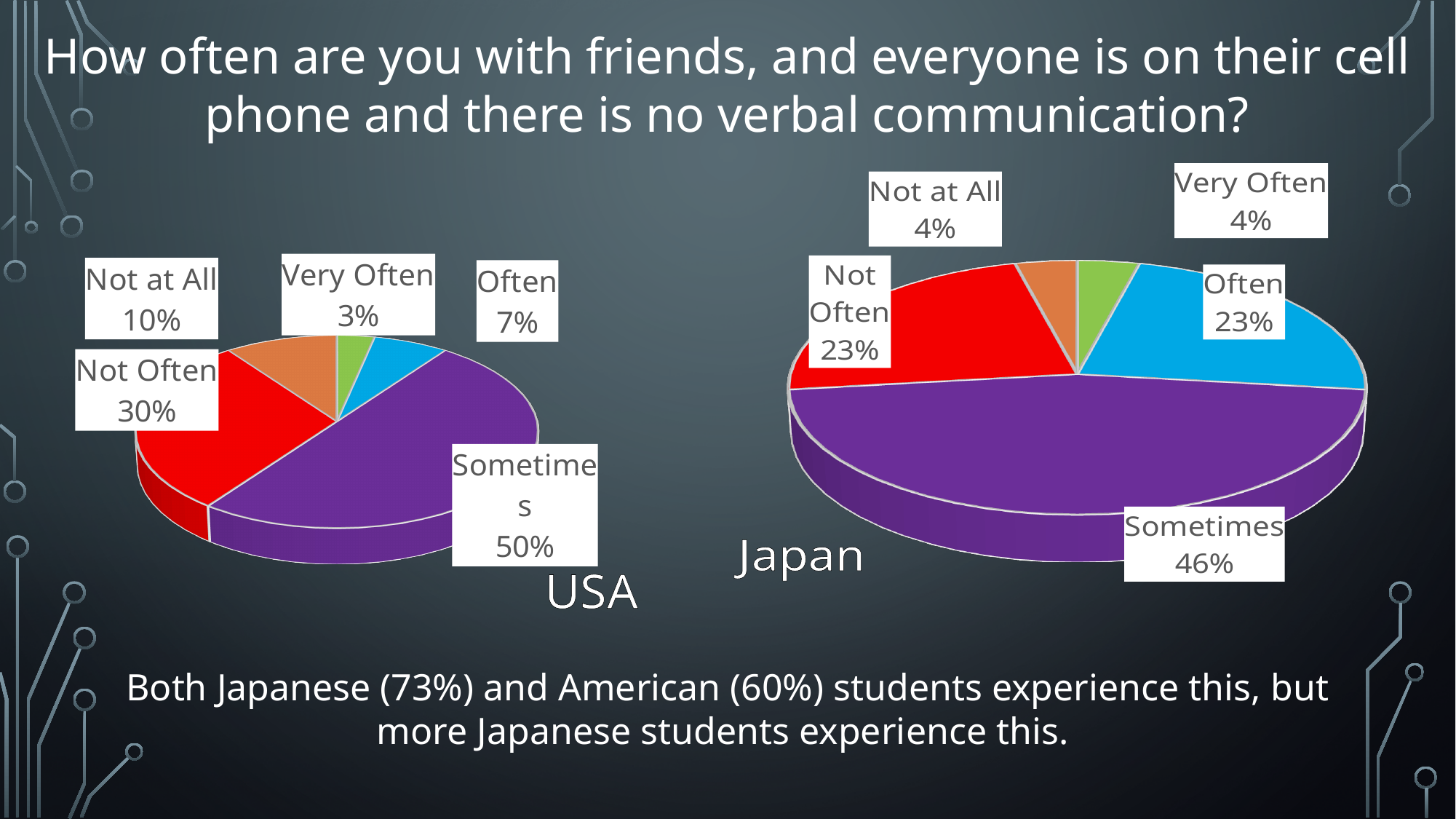
In the USA pie chart, what percentage answered Not Often? 30% In the USA pie chart, what percentage of respondents answered Sometimes? 50% In the Japan pie chart, what colour is the Sometimes slice? Purple In the USA pie chart, which category has the largest share? Sometimes In the Japan pie chart, which category has the largest share? Sometimes What type of chart is used for the Japan data? Pie chart In the USA pie chart, which category has the smallest share? Very Often What is the difference between the Often percentages in the Japan chart and the USA chart? 16% In the Japan pie chart, what percentage of respondents answered Often? 23% Which chart shows a larger share for Not at All, USA or Japan? USA In the Japan pie chart, what percentage answered Very Often? 4% How many categories does the USA pie chart have? 5